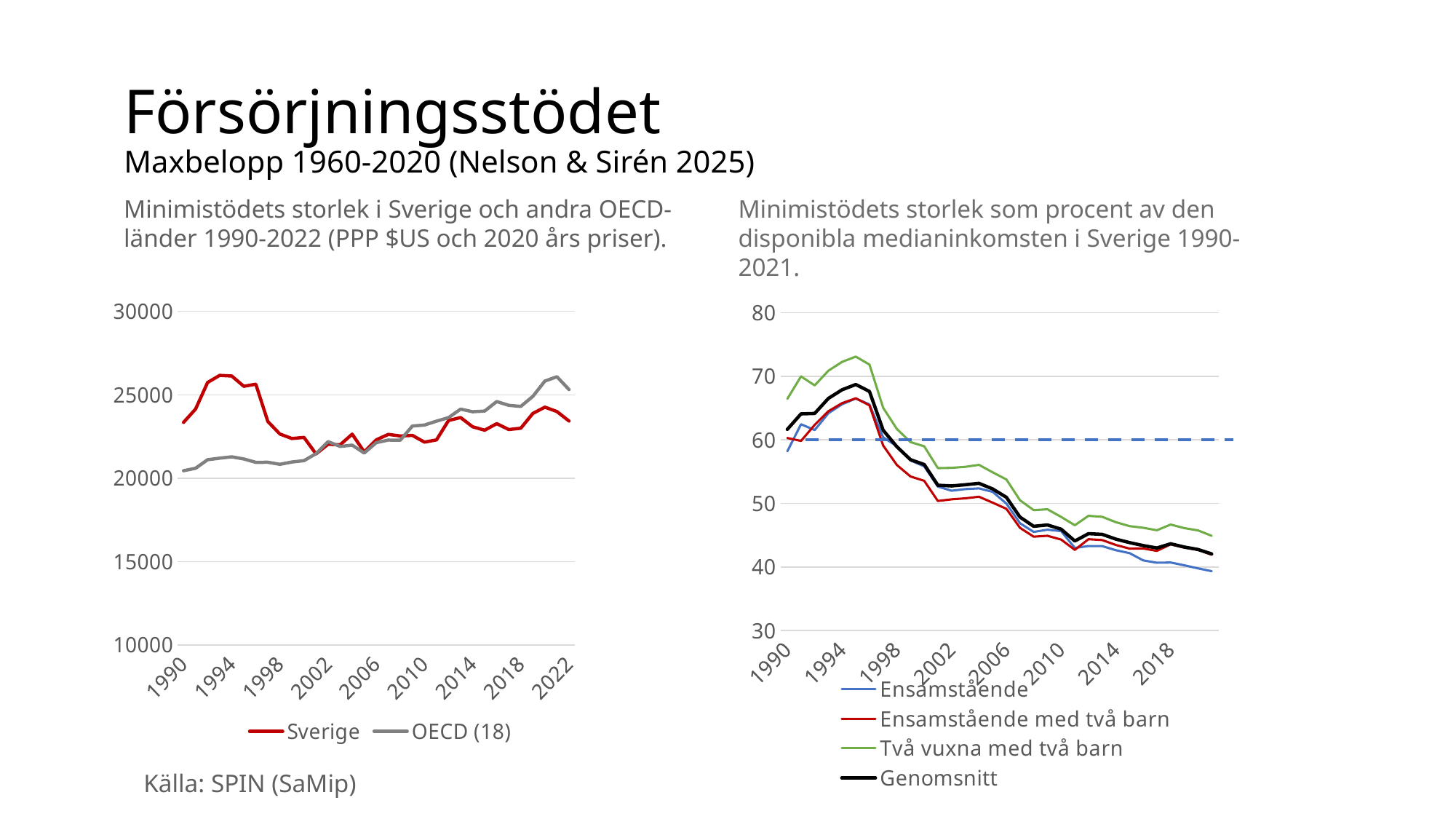
What kind of chart is the right chart (Minimistödets storlek som procent av den disponibla medianinkomsten)? line chart What kind of chart is the left chart (Minimistödets storlek i Sverige och andra OECD-länder)? line chart In the right chart, is the value for Ensamstående in 2021 greater or less than 40? less In the right chart, is the value for Två vuxna med två barn in 1996 greater or less than 70? greater In the right chart, which series is drawn in green? Två vuxna med två barn In the right chart, which series has the highest value in 1996? Två vuxna med två barn In the left chart, is the value for OECD (18) in 1990 greater or less than 25000? less How many series does the legend of the right chart list? 4 How many series does the legend of the left chart list? 2 In the right chart, do the values for Genomsnitt rise or fall between 1996 and 2021? fall